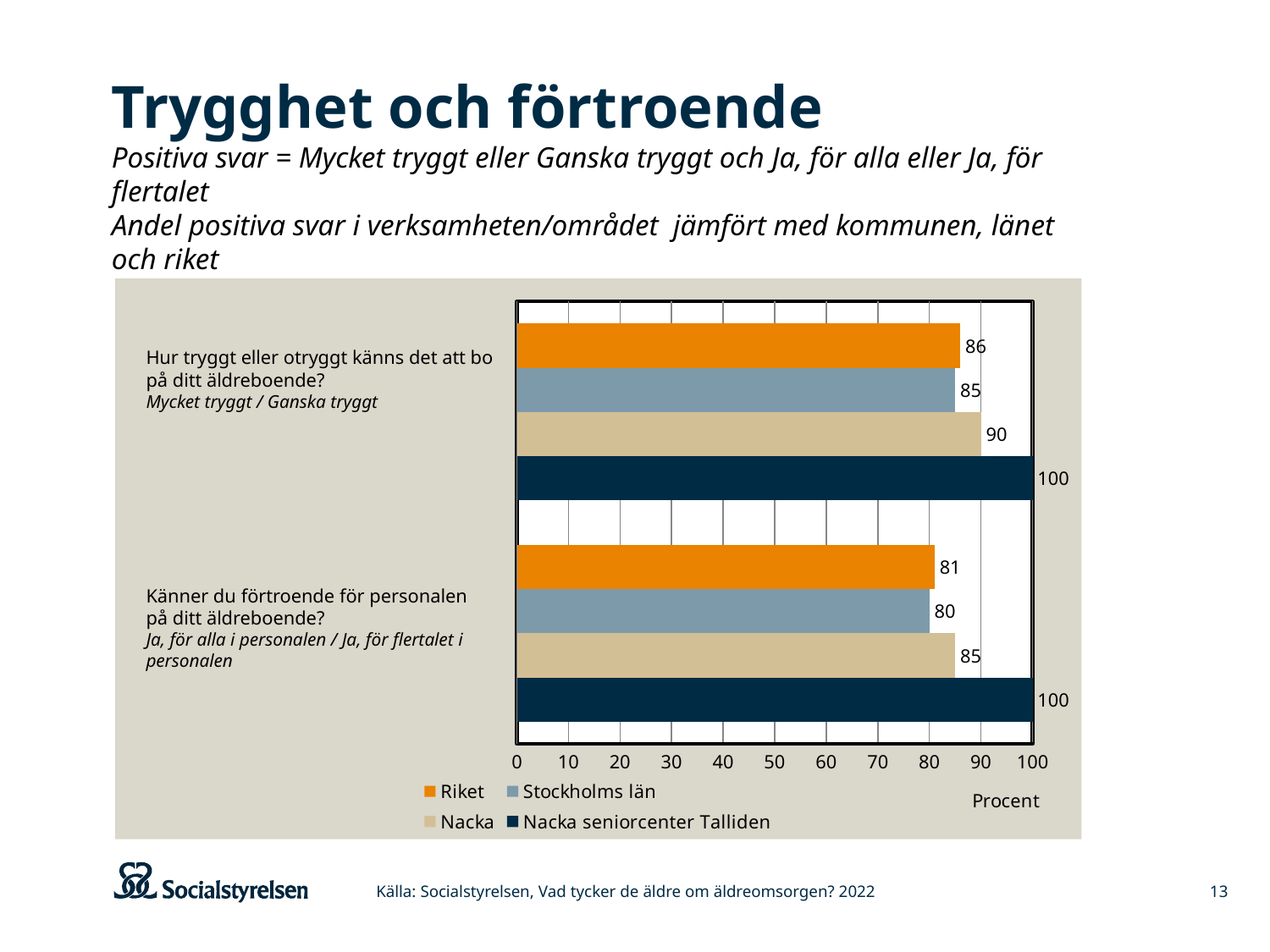
What kind of chart is shown on the slide? Bar chart Which series has the lowest value on the question 'Hur tryggt eller otryggt känns det att bo på ditt äldreboende?' Stockholms län What is the value for Riket on the question 'Hur tryggt eller otryggt känns det att bo på ditt äldreboende?' 86 What is the value for Nacka seniorcenter Talliden on the question 'Hur tryggt eller otryggt känns det att bo på ditt äldreboende?' 100 Which is larger on the question 'Hur tryggt eller otryggt känns det att bo på ditt äldreboende?': Nacka or Riket? Nacka What unit is shown on the x axis of the chart? Procent Which series has the highest value on the question 'Känner du förtroende för personalen på ditt äldreboende?' Nacka seniorcenter Talliden What is the value for Stockholms län on the question 'Känner du förtroende för personalen på ditt äldreboende?' 80 How many series does the legend list? 4 What is the value for Nacka on the question 'Känner du förtroende för personalen på ditt äldreboende?' 85 How many questions (categories) are shown on the chart? 2 What is the difference between Nacka seniorcenter Talliden and Riket on the question 'Känner du förtroende för personalen på ditt äldreboende?' 19